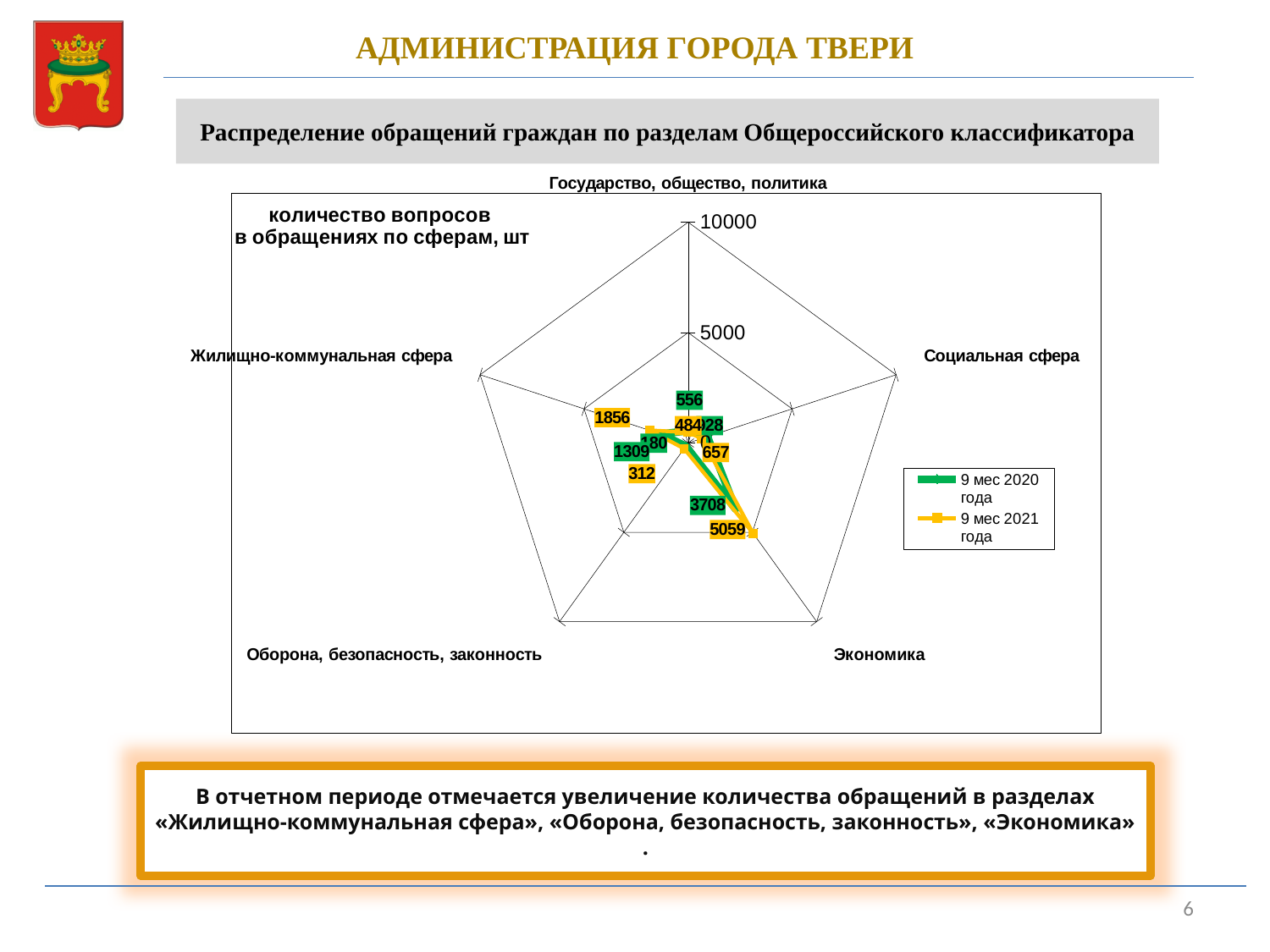
What is the value for «Оборона, безопасность, законность» for 9 мес 2021 года? 312 What is the value for «Жилищно-коммунальная сфера» for 9 мес 2021 года? 1856 Which category has the highest value for 9 мес 2021 года? Экономика How many series does the legend list? 2 What is the value for «Экономика» for 9 мес 2021 года? 5059 What is the value for «Экономика» for 9 мес 2020 года? 3708 What is the value for «Государство, общество, политика» for 9 мес 2020 года? 556 What is the value for «Жилищно-коммунальная сфера» for 9 мес 2020 года? 1309 How many categories (sectors) are plotted on the radar chart? 5 Which series has the larger value for «Жилищно-коммунальная сфера»: 9 мес 2020 года or 9 мес 2021 года? 9 мес 2021 года By how much did the value for «Экономика» increase from 9 мес 2020 года to 9 мес 2021 года? 1351 What type of chart is shown on the slide? Radar chart